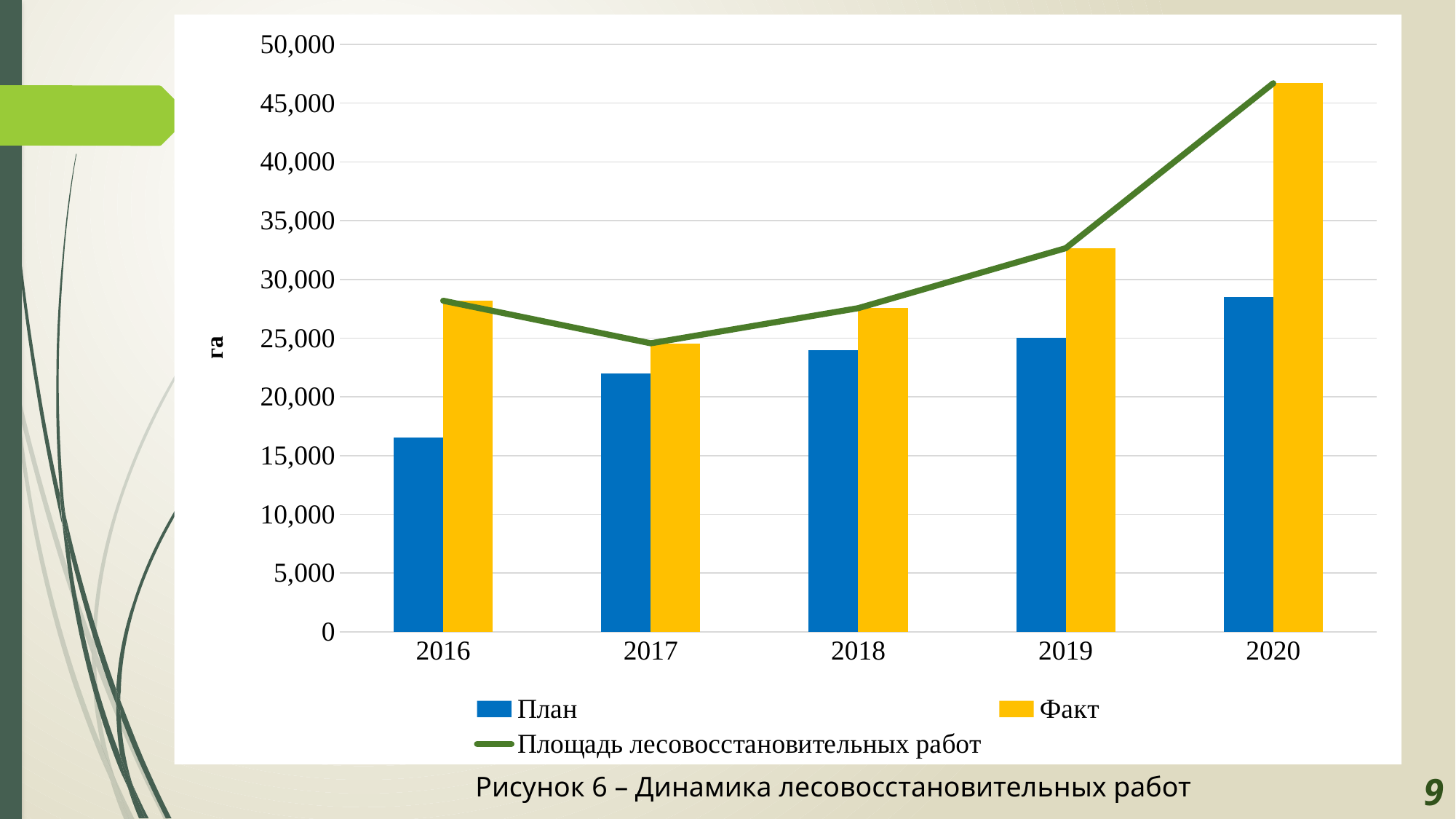
Is the План value for 2016 greater or less than 20,000? less What unit is shown on the vertical axis label of the chart? га Is the Факт value for 2020 greater or less than 45,000? greater How many series does the chart's legend list? 3 How many years are shown on the x axis of the chart? 5 What kind of chart is shown on the slide? A bar chart combined with a line In which year is the Факт bar the lowest? 2017 In which year is the План bar the lowest? 2016 In which year is the Факт bar the highest? 2020 In 2016, which is larger: the План bar or the Факт bar? Факт Is the Факт value for 2019 greater or less than 30,000? greater Do the План bars rise or fall from 2016 to 2020? rise